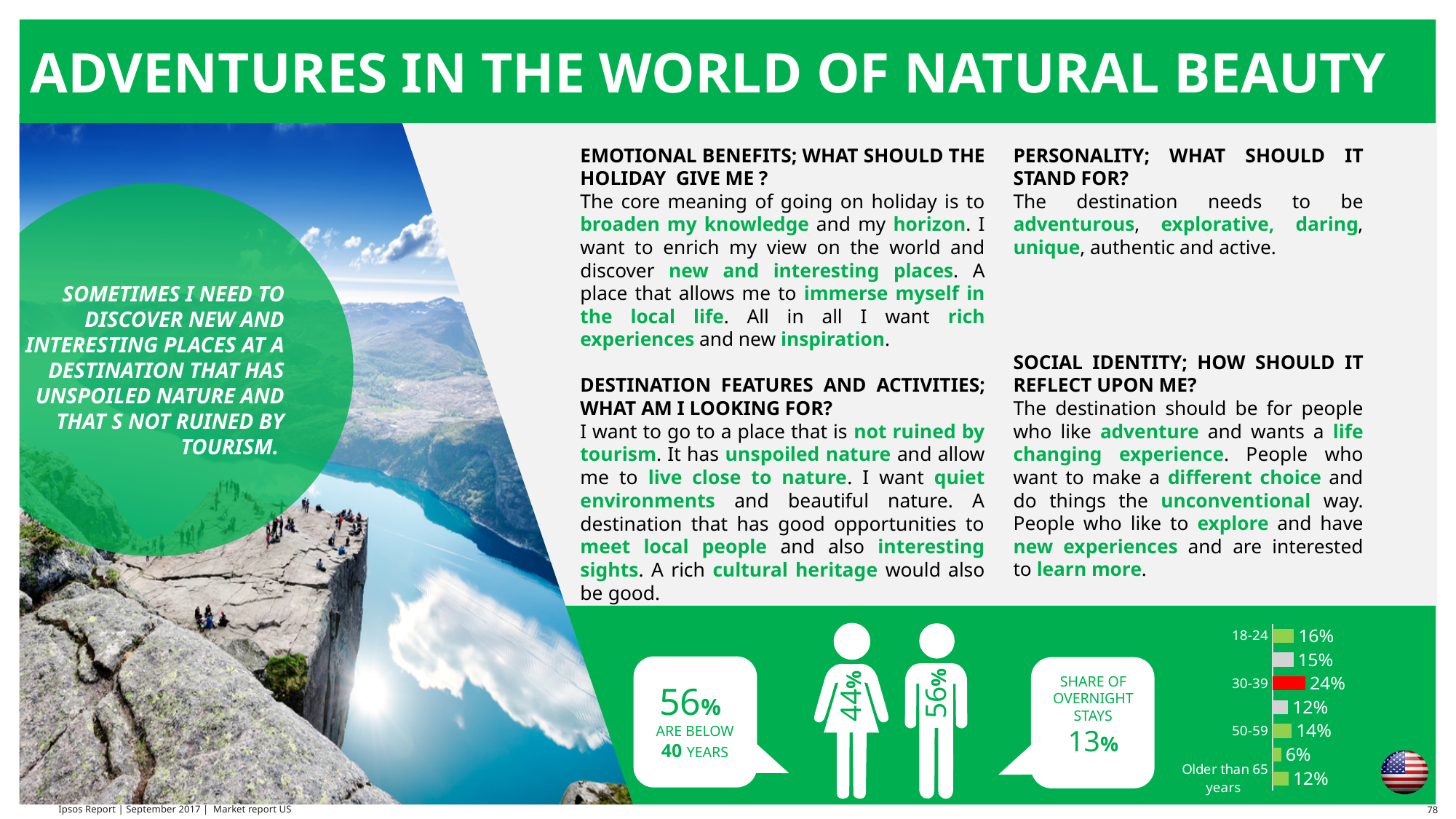
In the age-group bar chart at the bottom right, what is the value for the 18-24 age group? 16% In the age-group bar chart at the bottom right, what is the value for the 30-39 age group? 24% In the age-group bar chart at the bottom right, what is the value for people older than 65 years? 12% In the age-group bar chart at the bottom right, which is larger: the value for 30-39 or the value for older than 65 years? 30-39 What kind of chart is the age-group chart at the bottom right of the slide? Bar chart In the age-group bar chart at the bottom right, what is the lowest value shown on any bar? 6% In the age-group bar chart at the bottom right, what is the value for the 50-59 age group? 14% In the age-group bar chart at the bottom right, which is larger: the value for 18-24 or the value for 50-59? 18-24 In the age-group bar chart at the bottom right, which age group's bar is coloured red? 30-39 How many bars are shown in the age-group bar chart at the bottom right? 7 In the age-group bar chart at the bottom right, how many percentage points higher is the 30-39 group than the 18-24 group? 8 percentage points In the age-group bar chart at the bottom right, which labelled age group has the highest value? 30-39